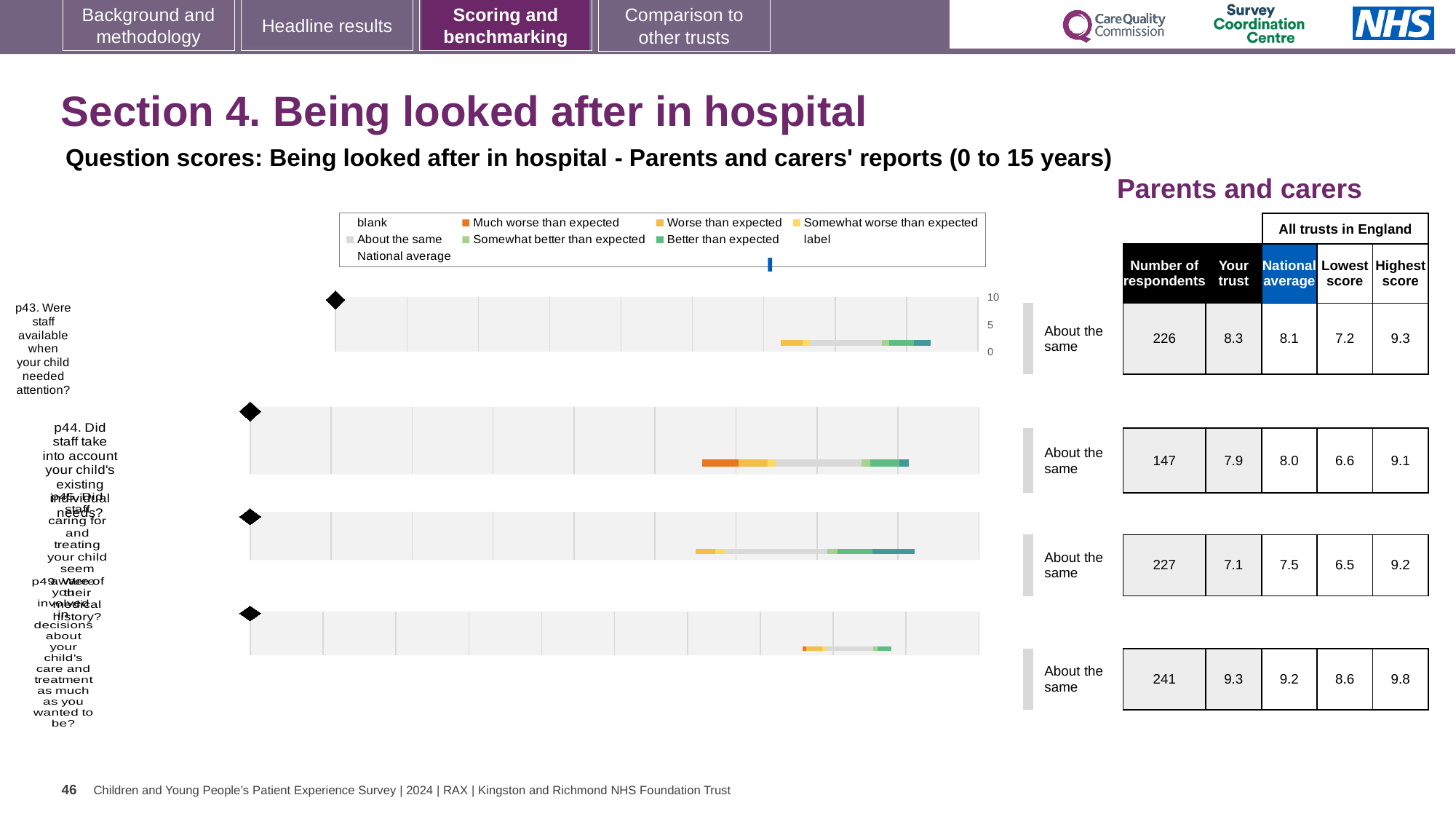
What is the title of the chart? Question scores: Being looked after in hospital - Parents and carers' reports (0 to 15 years) What kind of chart is used to show the question scores on this slide? bar chart For p45, which is larger: the 'Your trust' score or the national average? National average What benchmark category is shown for p44? About the same What is the lowest score among all trusts in England for p45? 6.5 What is the 'Your trust' score for p43 (Were staff available when your child needed attention?)? 8.3 What is the difference between the 'Your trust' score and the national average for p43? 0.2 What is the highest score among all trusts in England for p49? 9.8 Which question has the lowest 'Your trust' score? p45 How many survey questions are plotted in the chart? 4 How many respondents are listed for p44 (Did staff take into account your child's existing individual needs?)? 147 Which question has the highest 'Your trust' score? p49